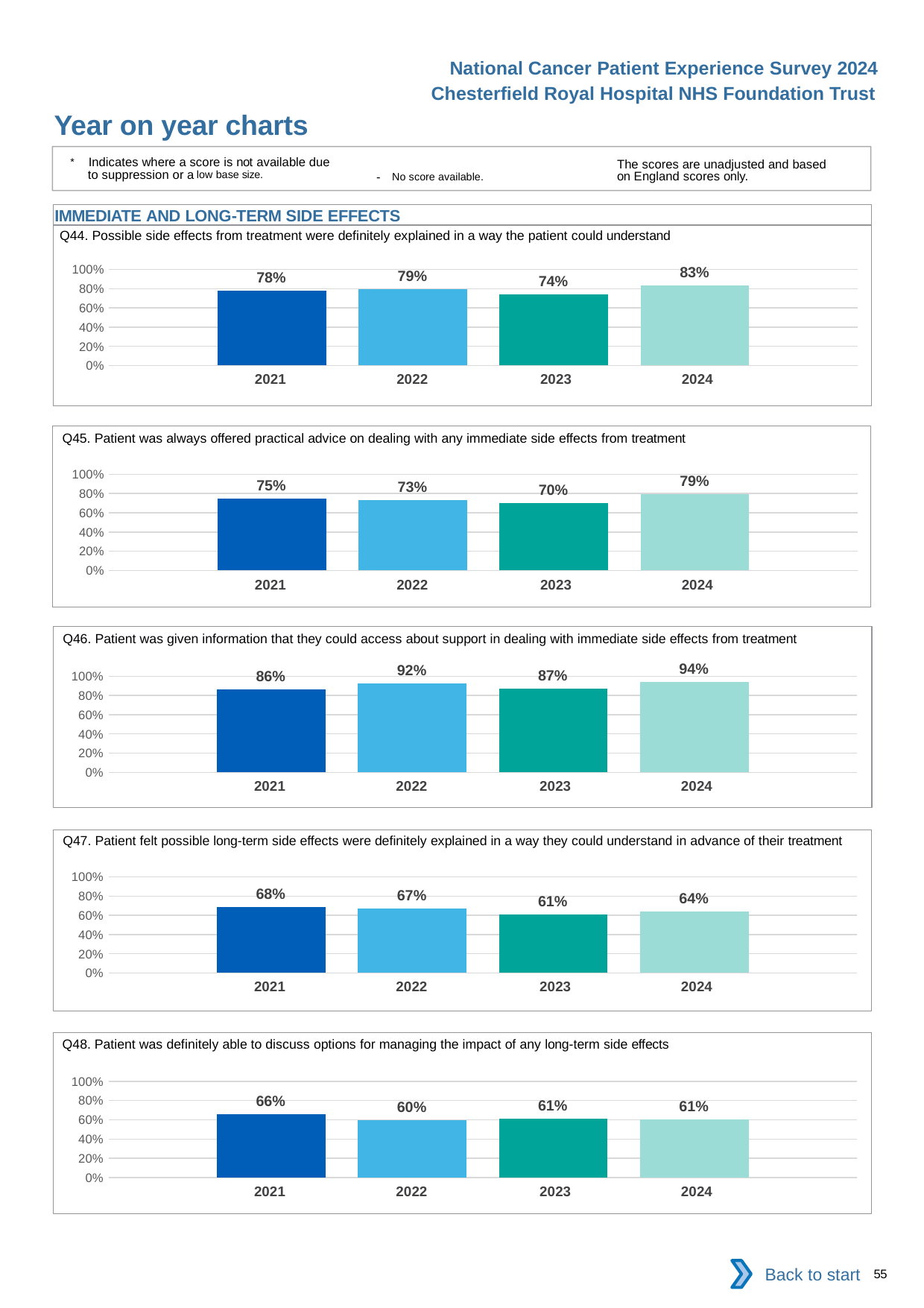
In the Q45 chart, what is the value for 2021? 75% In the Q47 chart, what is the difference between the 2021 and 2023 values? 7% In the Q44 chart, what is the value for 2024? 83% In the Q48 chart, is the value for 2021 greater or less than 60%? greater How many years are shown in the Q45 chart? 4 In the Q44 chart, is the value for 2023 larger or smaller than the value for 2022? smaller In the Q47 chart, which year has the highest value? 2021 In the Q48 chart, what is the value for 2022? 60% What kind of chart is the Q46 chart? bar chart In the Q46 chart, what is the difference between the 2024 and 2021 values? 8% In the Q46 chart, which year has the highest value? 2024 In the Q45 chart, which year has the lowest value? 2023